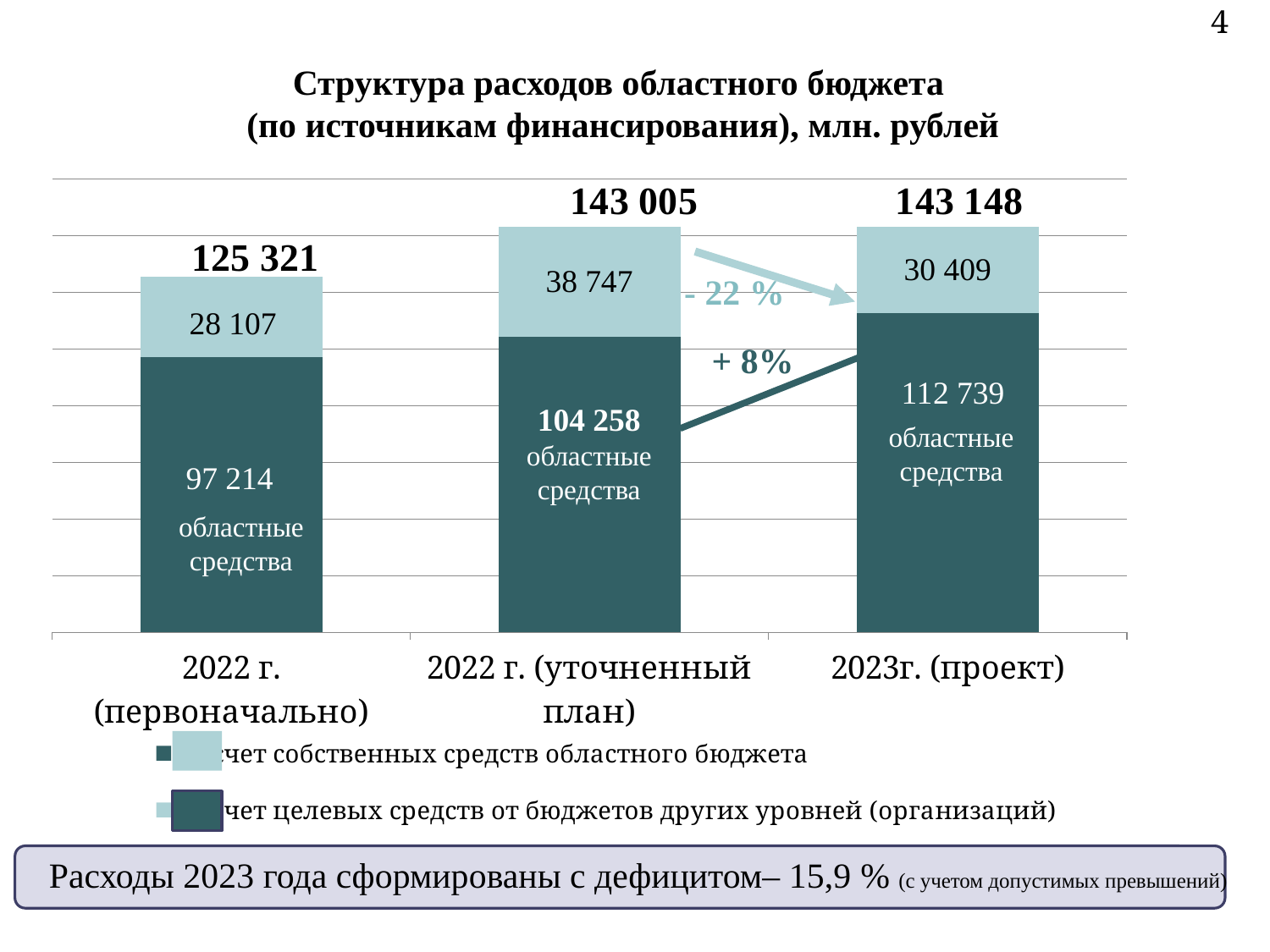
What is the total expenditure shown for 2023г. (проект)? 143 148 What kind of chart is shown on the slide? Stacked bar chart Which is larger: the upper (light) segment for 2022 г. (первоначально) or for 2023г. (проект)? 2023г. (проект) How many categories are shown on the x axis? 3 Which category has the highest value of областные средства? 2023г. (проект) Do the values of областные средства rise or fall from left to right across the categories? Rise By how much does the upper (light) segment for 2022 г. (уточненный план) exceed that for 2023г. (проект)? 8 338 What is the value of областные средства for 2022 г. (уточненный план)? 104 258 Which category has the lowest total expenditure? 2022 г. (первоначально) What is the value of the upper (light) segment for 2022 г. (первоначально)? 28 107 What is the difference in областные средства between 2022 г. (уточненный план) and 2022 г. (первоначально)? 7 044 How many series does the legend list? 2